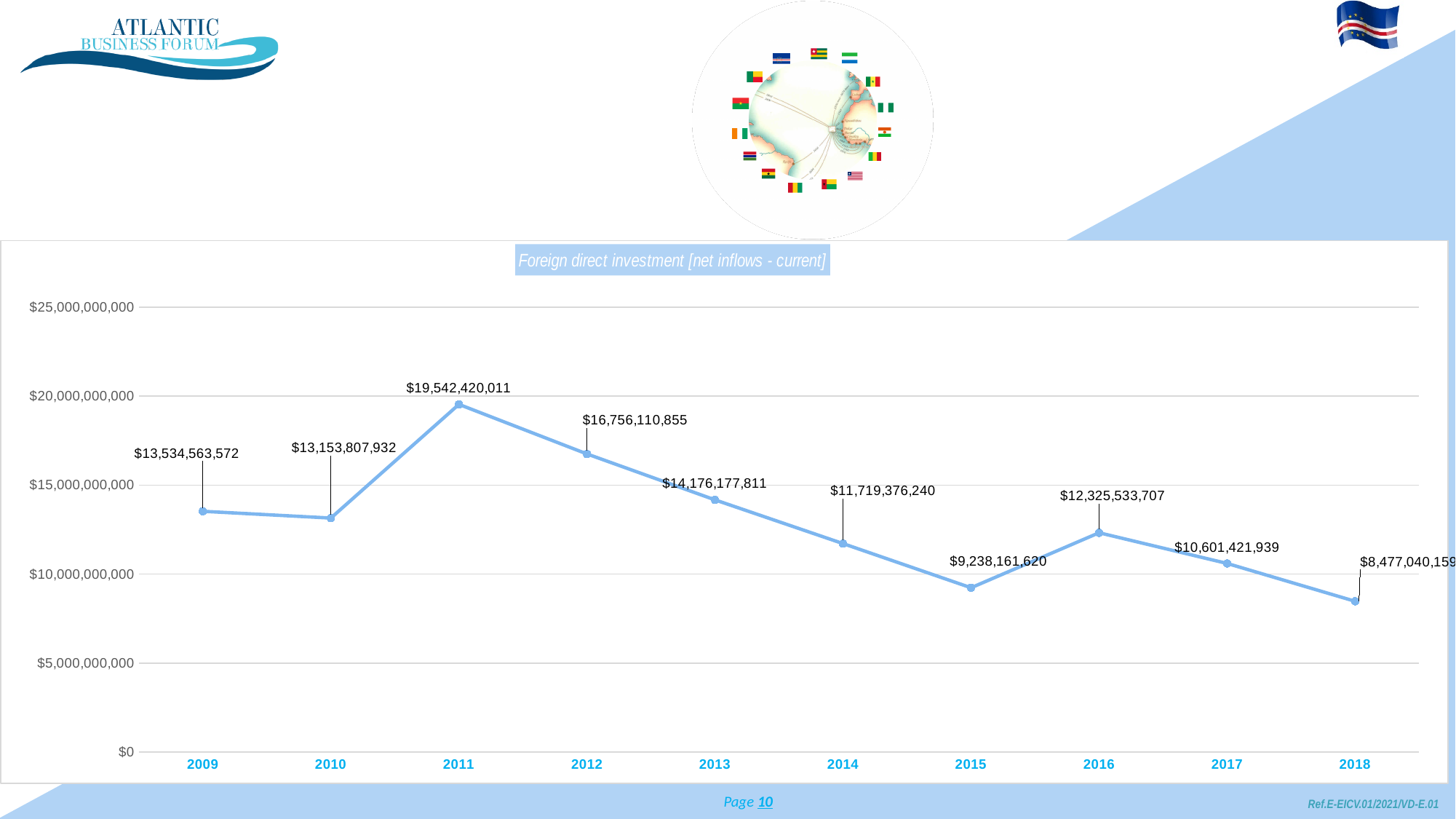
What type of chart is shown on the slide? Line chart Which year has the highest foreign direct investment value? 2011 Which year has the lowest foreign direct investment value? 2018 What is the difference between the 2011 value and the 2018 value? $11,065,379,852 What is the value of foreign direct investment in 2011? $19,542,420,011 Which year has a larger value, 2016 or 2017? 2016 What is the value of foreign direct investment in 2018? $8,477,040,159 What is the title of the chart? Foreign direct investment [net inflows - current] How many years are plotted on the chart? 10 Is the value for 2012 greater or less than $15,000,000,000? greater What is the difference between the 2009 value and the 2010 value? $380,755,640 What is the value of foreign direct investment in 2015? $9,238,161,620